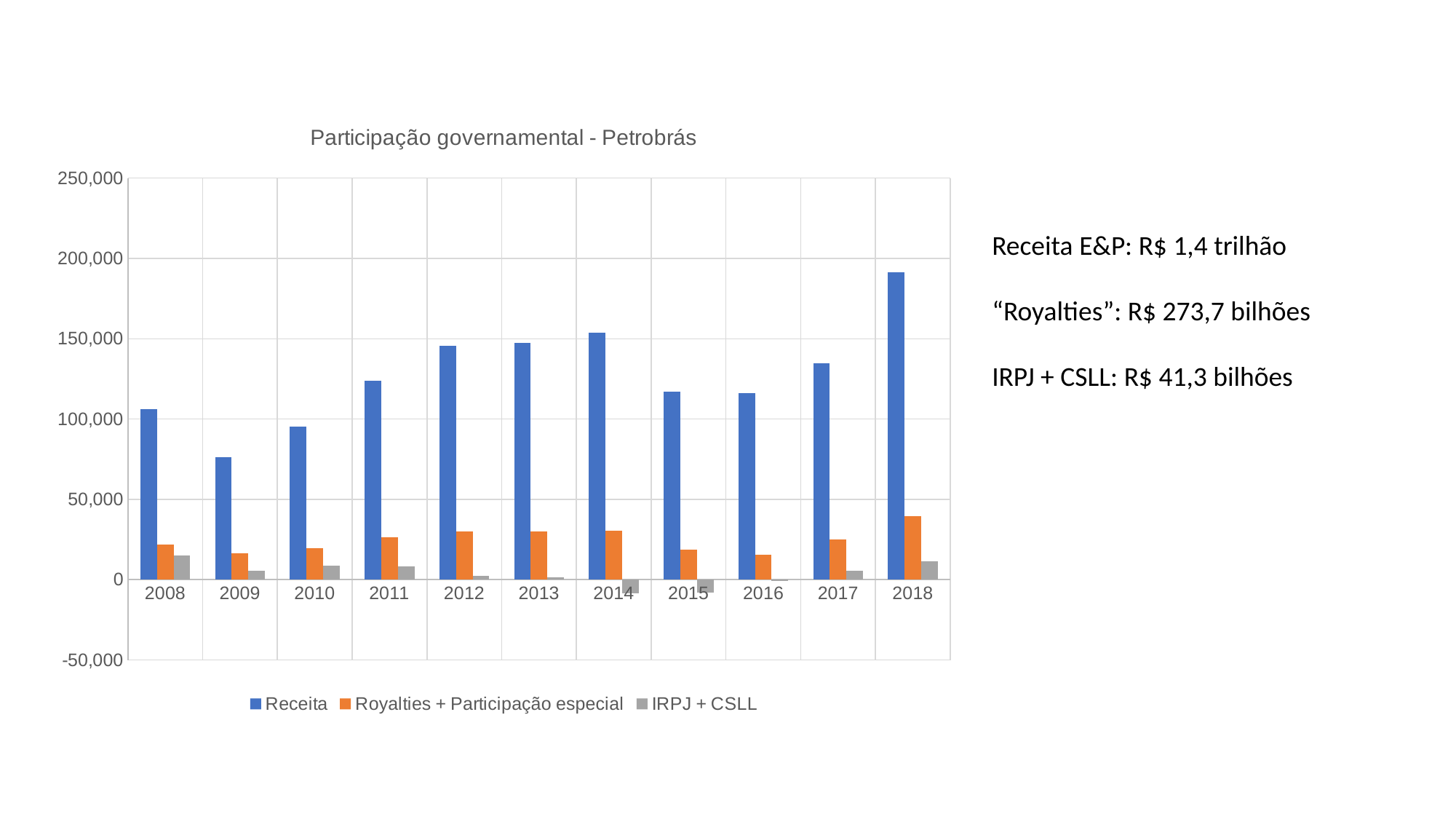
Is the Receita value for 2018 greater or less than 150,000? greater In which year is Receita highest? 2018 How many series does the legend list? 3 Is the Receita value for 2009 greater or less than 100,000? less In which year is Receita lowest? 2009 How many years are shown on the x axis? 11 Is the Royalties + Participação especial value for 2018 greater or less than 50,000? less In which year is IRPJ + CSLL highest? 2008 Does Receita rise or fall from 2009 to 2014? rise In which year is Royalties + Participação especial highest? 2018 Which year has the larger Receita value, 2011 or 2010? 2011 What kind of chart is shown on the slide? bar chart